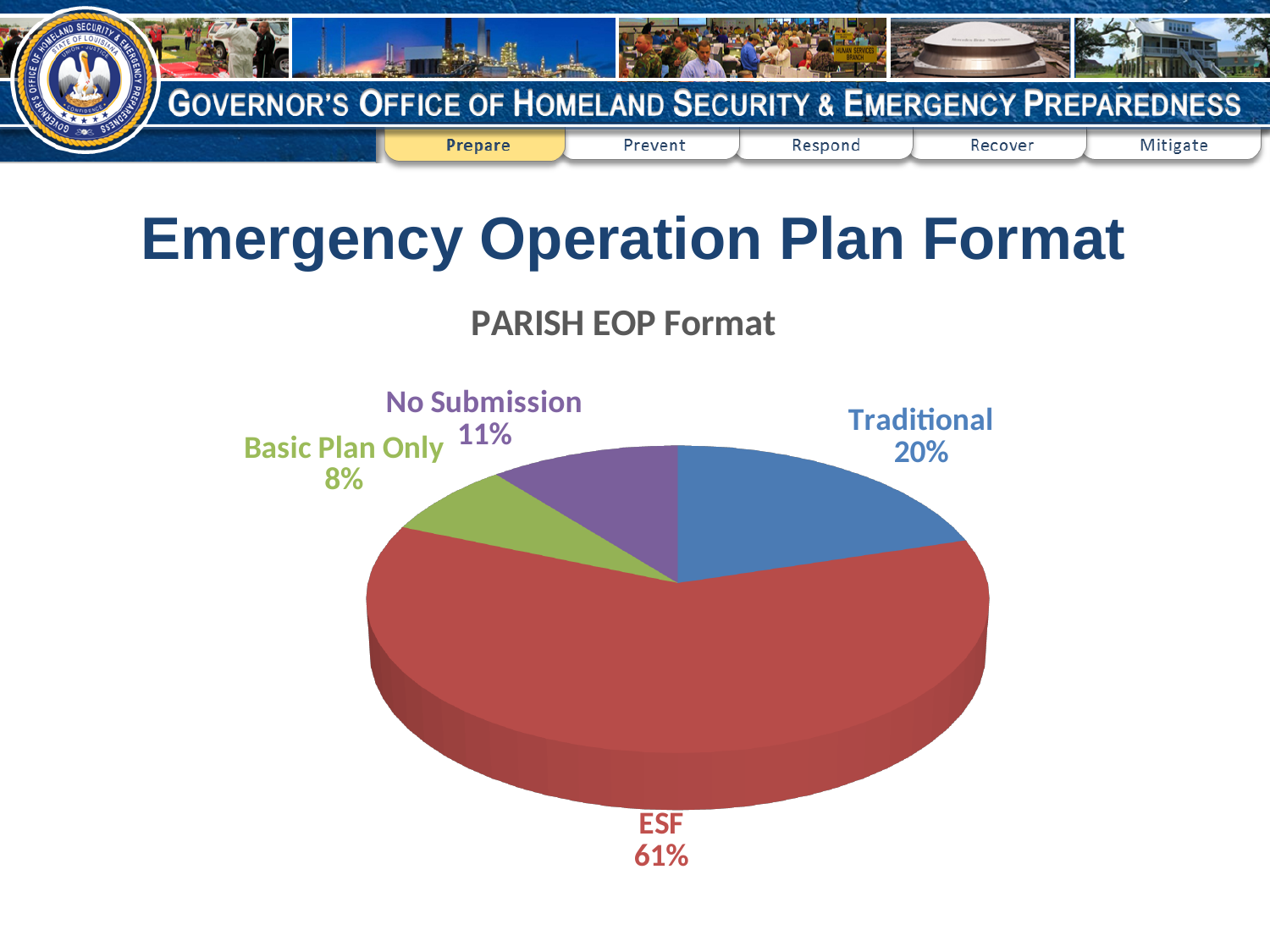
What type of chart is shown on the slide? Pie chart What colour is the ESF slice? Red Which category has the largest slice of the pie? ESF What is the title of the chart? PARISH EOP Format What share of the pie is Basic Plan Only? 8% What percentage of parishes use the ESF format? 61% How many categories are shown in the pie chart? 4 Which is larger, No Submission or Basic Plan Only? No Submission What share of the pie is No Submission? 11% What percentage of parishes use the Traditional format? 20% What is the difference in percentage points between ESF and Traditional? 41 Which category has the smallest slice of the pie? Basic Plan Only